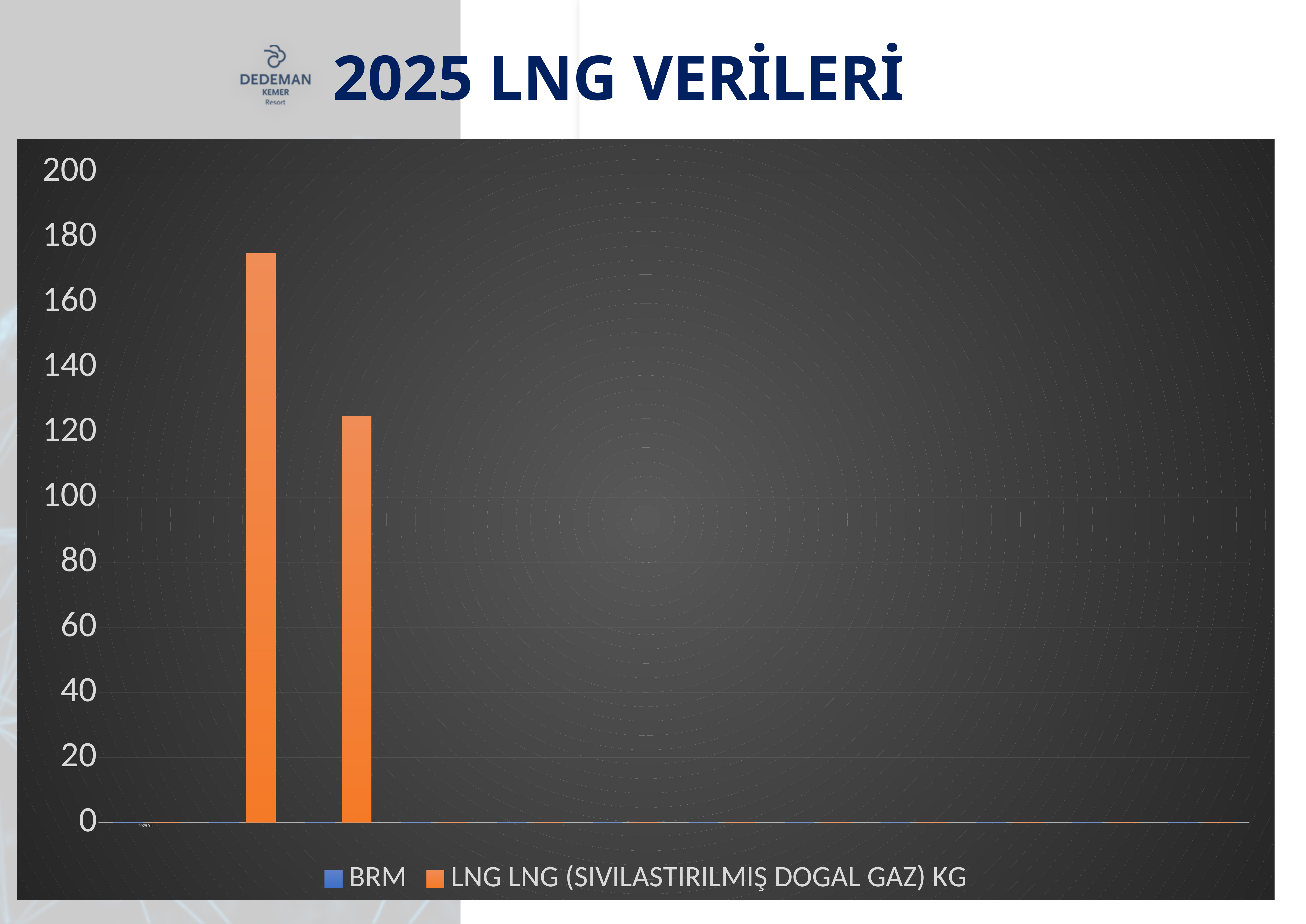
How many series does the legend list? 2 Which bar is taller, the left bar or the right bar? the left bar Is the value of the left bar greater or less than 180? less Is the value of the left bar greater or less than 160? greater Is the value of the right bar greater or less than 140? less Do the bar values rise or fall from left to right? fall What colour are the plotted bars in the chart? orange What kind of chart is shown on the slide? bar chart What is the highest value shown on the vertical axis? 200 How many bars are plotted in the chart? 2